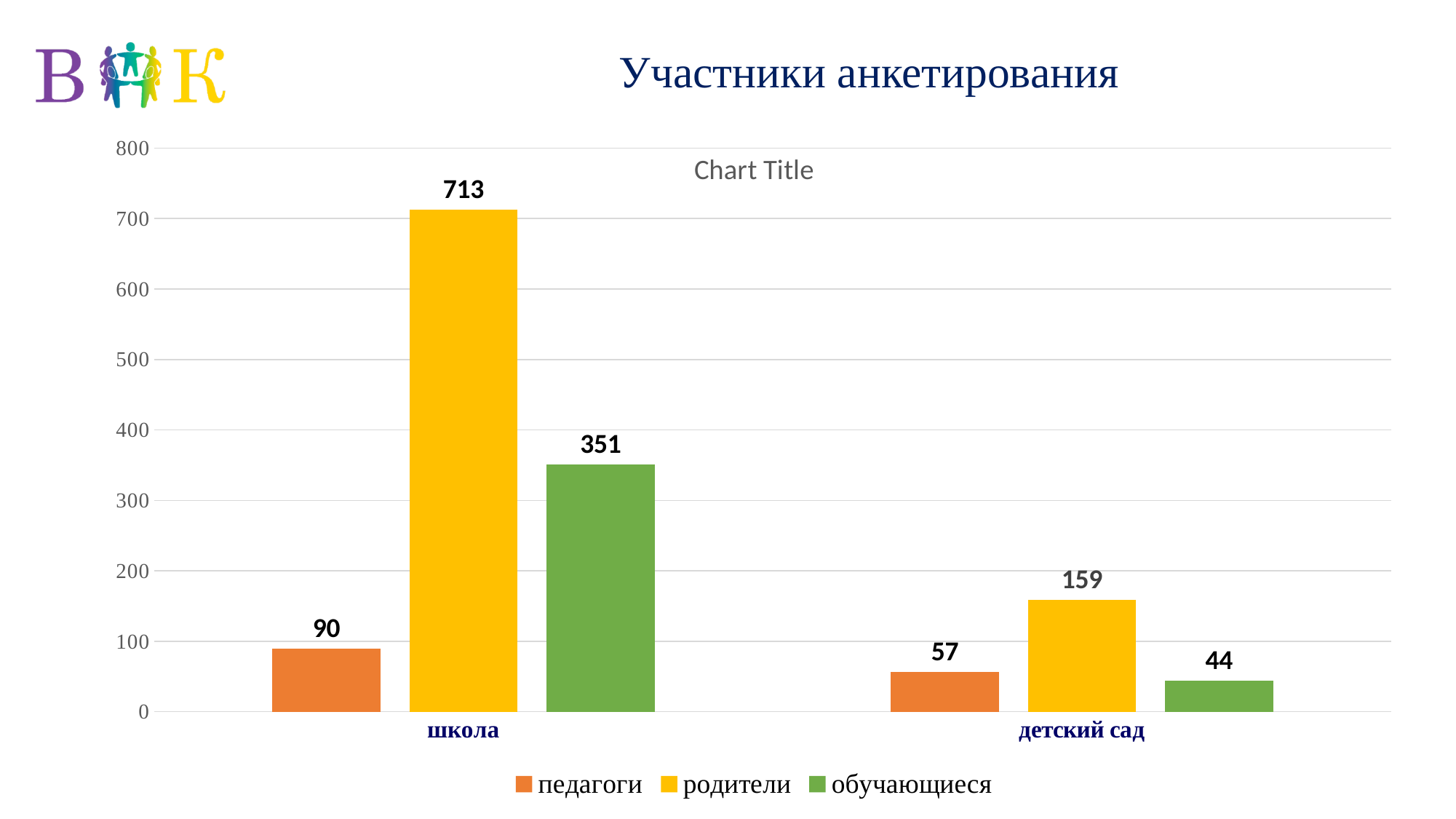
How many series does the legend list? 3 How many categories are shown on the x axis? 2 Which series has the highest value in the школа category? родители What is the value for родители in the школа category? 713 What kind of chart is shown on the slide? bar chart Is the value for обучающиеся in the школа category greater or less than 300? greater What is the value for педагоги in the детский сад category? 57 Which is larger: педагоги for школа or педагоги for детский сад? педагоги for школа What is the difference between the родители values for школа and детский сад? 554 What colour are the bars for the родители series? yellow What is the value for обучающиеся in the детский сад category? 44 Which series has the lowest value in the детский сад category? обучающиеся